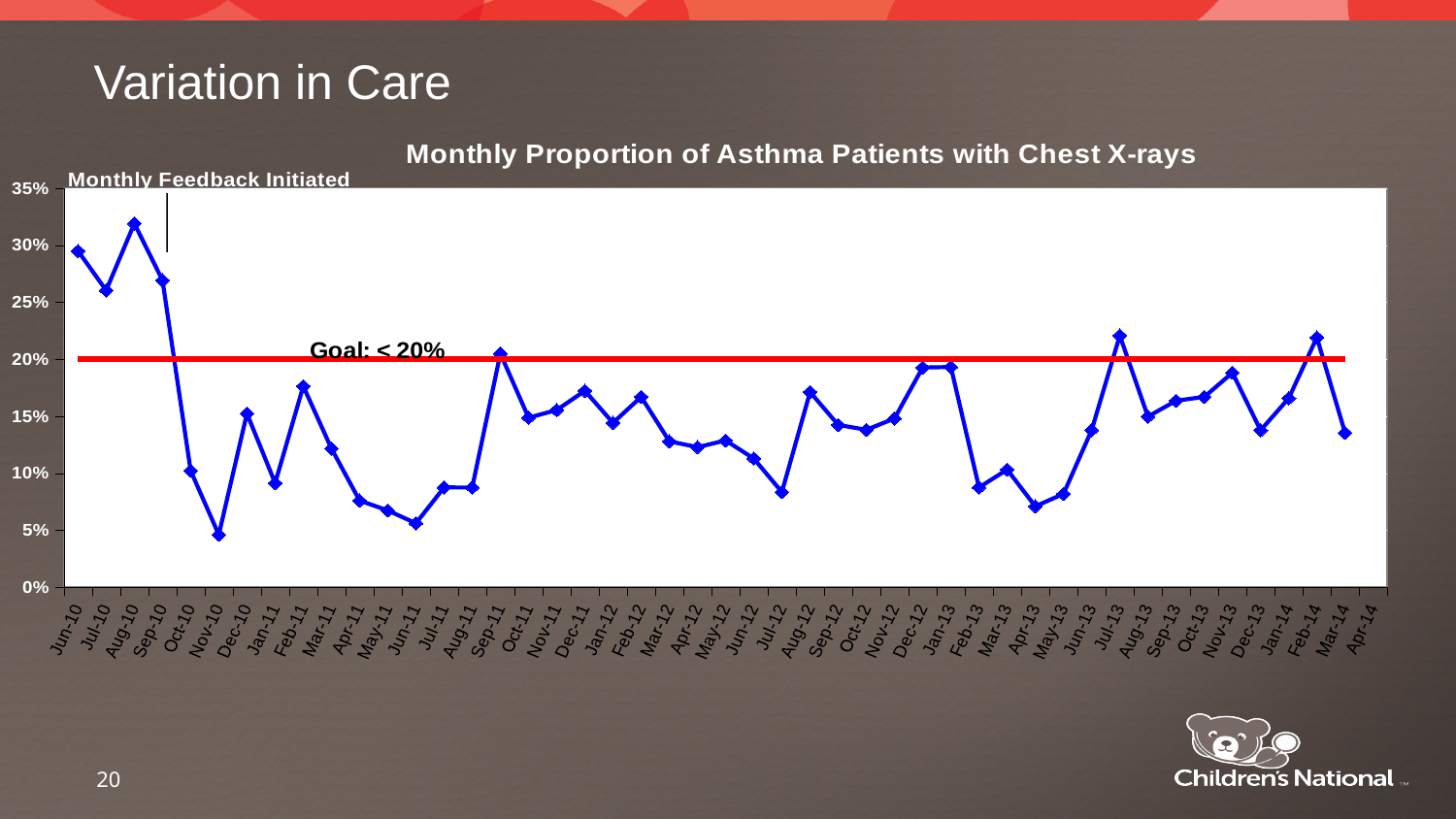
Is the value for Apr-13 greater or less than 10%? less Is the value for Jul-13 greater or less than 20%? greater Is the value for Jun-10 greater or less than 25%? greater What goal value is marked by the red horizontal line on the chart? Goal: < 20% Which is larger, the value for Jun-10 or the value for Mar-14? Jun-10 Do the values rise or fall from Aug-10 to Nov-10? fall Which month has the highest proportion of asthma patients with chest X-rays? Aug-10 What is the title of the chart? Monthly Proportion of Asthma Patients with Chest X-rays What kind of chart is shown on the slide? Line chart Which is larger, the value for Aug-10 or the value for Nov-10? Aug-10 Which month has the lowest proportion of asthma patients with chest X-rays? Nov-10